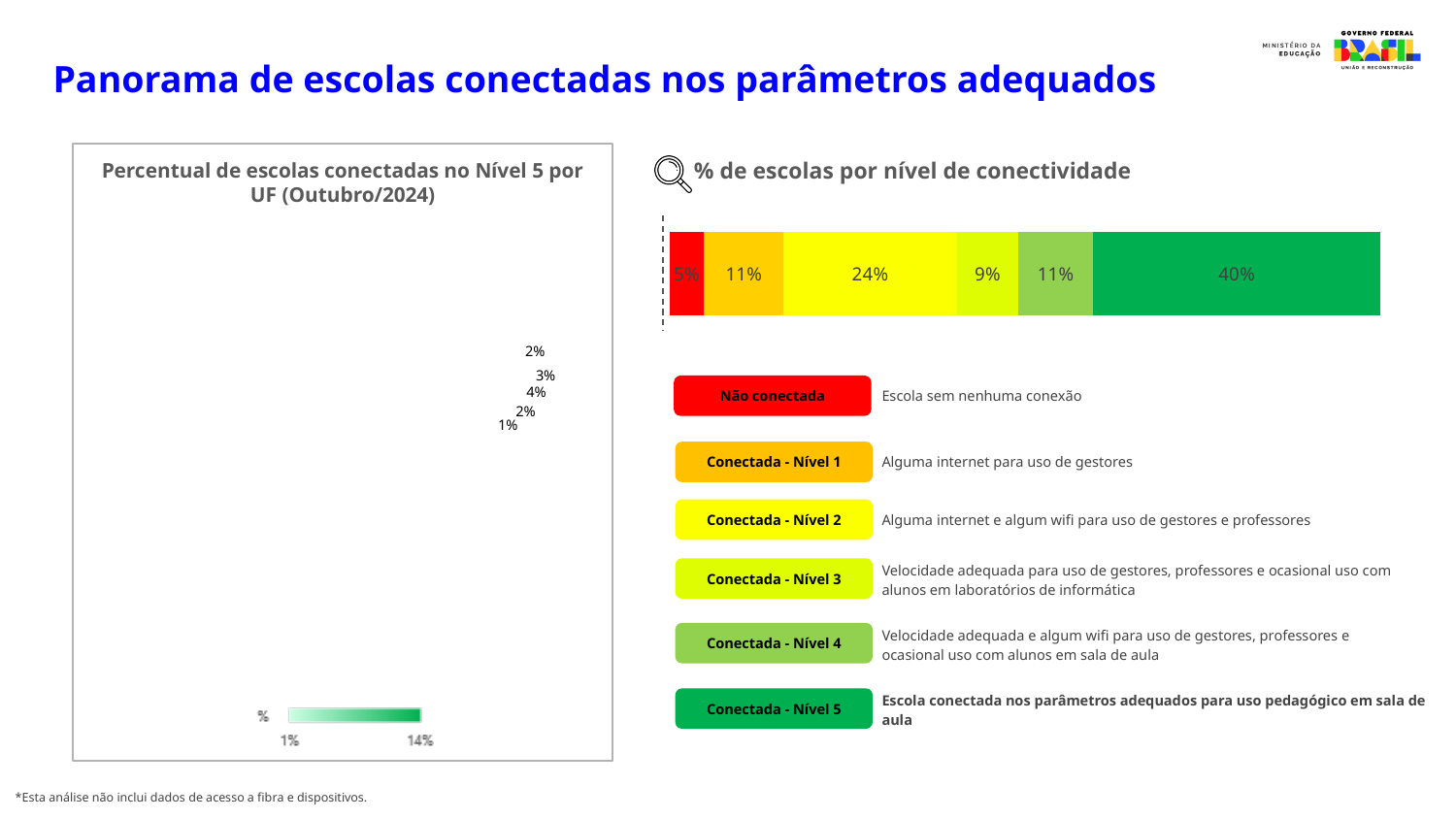
In the '% de escolas por nível de conectividade' chart, which category has the smallest share of schools? Não conectada In the '% de escolas por nível de conectividade' chart, what percentage of schools are at Conectada - Nível 5? 40% What is the total of all segments in the '% de escolas por nível de conectividade' bar? 100% In the '% de escolas por nível de conectividade' chart, what percentage of schools are at Conectada - Nível 2? 24% In the '% de escolas por nível de conectividade' chart, what percentage of schools are at Conectada - Nível 3? 9% How many segments does the '% de escolas por nível de conectividade' bar contain? 6 In the '% de escolas por nível de conectividade' chart, how many percentage points larger is the Nível 5 share than the Nível 2 share? 16 percentage points In the '% de escolas por nível de conectividade' chart, which connectivity level has the largest share of schools? Conectada - Nível 5 What kind of chart is the '% de escolas por nível de conectividade' chart? Stacked bar chart In the '% de escolas por nível de conectividade' chart, which has a larger share: Conectada - Nível 1 or Conectada - Nível 3? Conectada - Nível 1 In the '% de escolas por nível de conectividade' chart, what percentage of schools are Não conectada? 5% What is the title of the chart on the left side of the slide? Percentual de escolas conectadas no Nível 5 por UF (Outubro/2024)